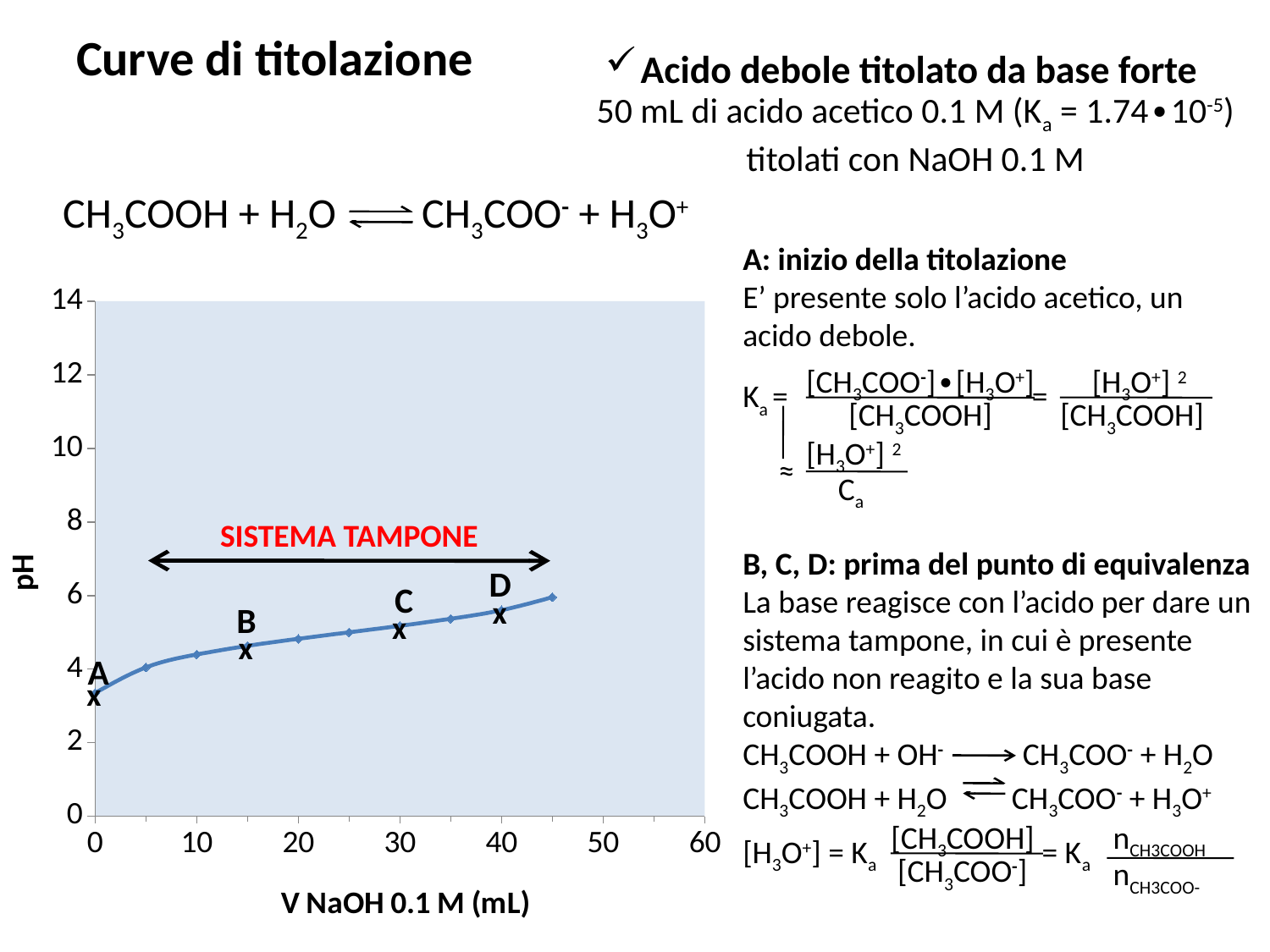
At which volume of NaOH is the plotted pH highest? 45 What is the title of the x axis of the chart? V NaOH 0.1 M (mL) How many data points are plotted on the curve? 10 What kind of chart is shown on the slide? line chart At which volume of NaOH is the plotted pH lowest? 0 Is the pH at point A (0 mL NaOH) greater or less than 4? less Which point has the higher pH, B or D? D Is the pH at point D (40 mL NaOH) greater or less than 6? less What is the title of the y axis of the chart? pH Does the pH rise or fall as the volume of NaOH increases along the x axis? rises Is the pH at point B (15 mL NaOH) greater or less than 4? greater Which point has the lower pH, A or C? A